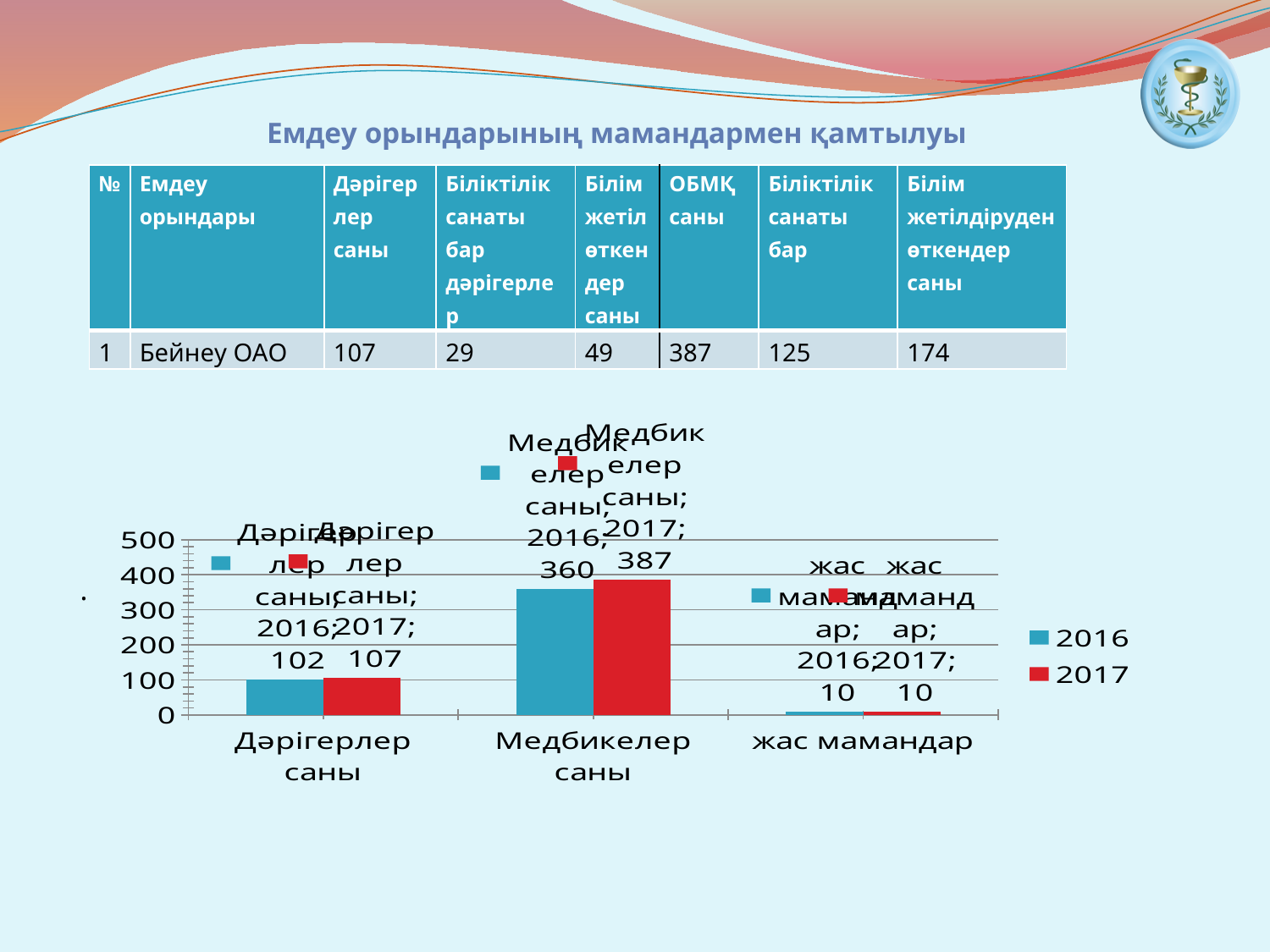
What is the value for Дәрігерлер саны in the 2016 series? 102 Which category has the highest value in the 2017 series? Медбикелер саны What is the difference between the 2017 and 2016 values for Медбикелер саны? 27 How many series does the chart legend list? 2 What is the value for жас мамандар in the 2017 series? 10 What is the difference between the 2017 and 2016 values for Дәрігерлер саны? 5 Which category has the lowest value in the 2016 series? жас мамандар What is the value for Медбикелер саны in the 2016 series? 360 What is the value for Дәрігерлер саны in the 2017 series? 107 What kind of chart is shown on the slide? bar chart How many categories are shown on the x axis of the chart? 3 What is the value for Медбикелер саны in the 2017 series? 387